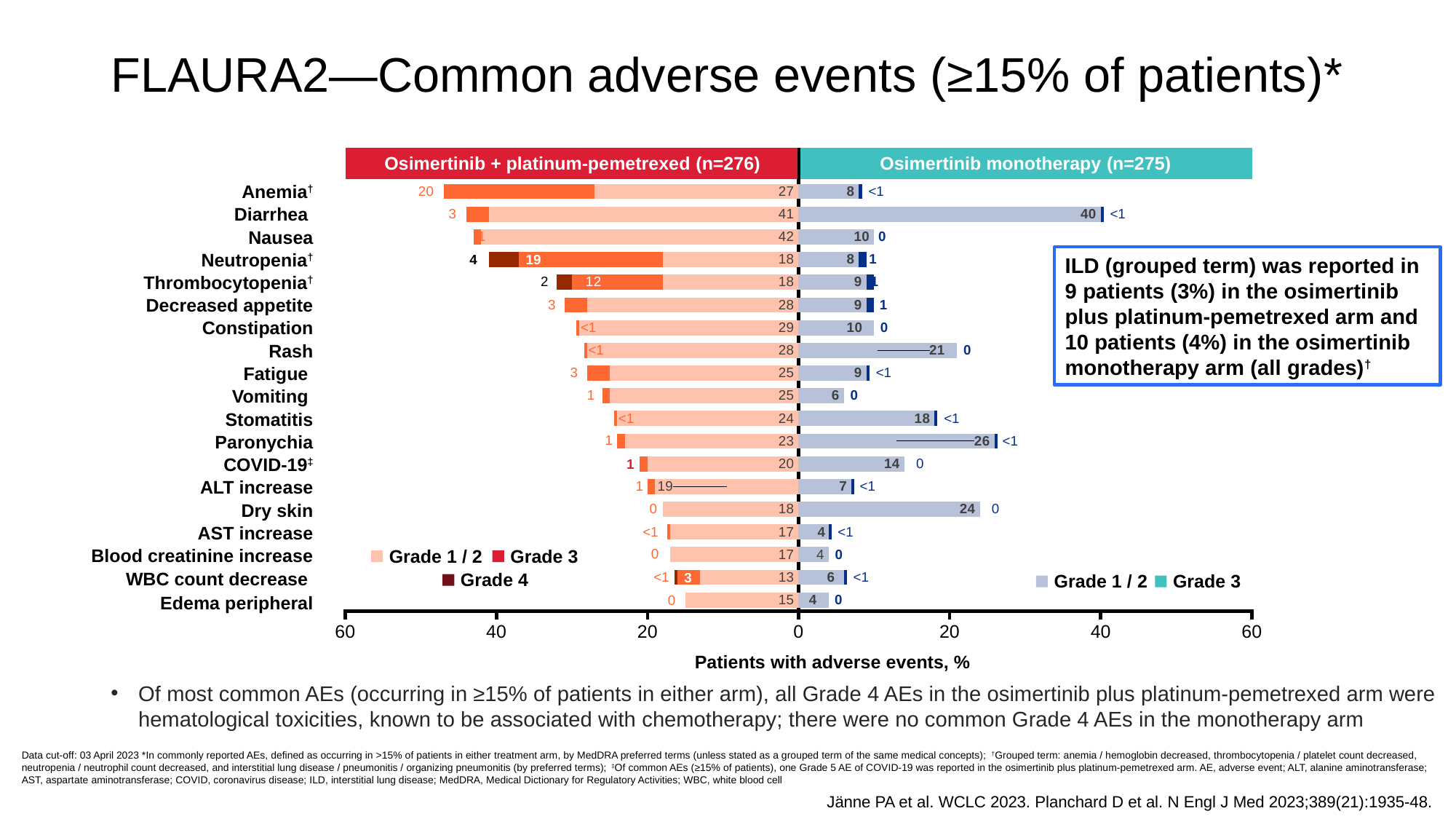
Which adverse event has the highest Grade 1 / 2 value in the Osimertinib monotherapy arm? Diarrhea What is the Grade 4 value for Neutropenia in the Osimertinib + platinum-pemetrexed arm? 4 What is the Grade 3 value for Anemia in the Osimertinib + platinum-pemetrexed arm? 20 What kind of chart is shown on the slide? Bar chart What is the label of the x axis of the chart? Patients with adverse events, % What is the Grade 1 / 2 value for Paronychia in the Osimertinib monotherapy arm? 26 What is the Grade 1 / 2 value for Nausea in the Osimertinib + platinum-pemetrexed arm? 42 How many grade categories does the legend for the Osimertinib + platinum-pemetrexed arm list? 3 Which arm has the larger Grade 1 / 2 value for Rash: Osimertinib + platinum-pemetrexed or Osimertinib monotherapy? Osimertinib + platinum-pemetrexed What is the total percentage of patients with Neutropenia of any grade in the Osimertinib + platinum-pemetrexed arm (Grade 1 / 2 + Grade 3 + Grade 4)? 41 How many adverse events are listed on the chart? 19 What is the difference between the Grade 1 / 2 values for Dry skin in the Osimertinib monotherapy arm and the Osimertinib + platinum-pemetrexed arm? 6